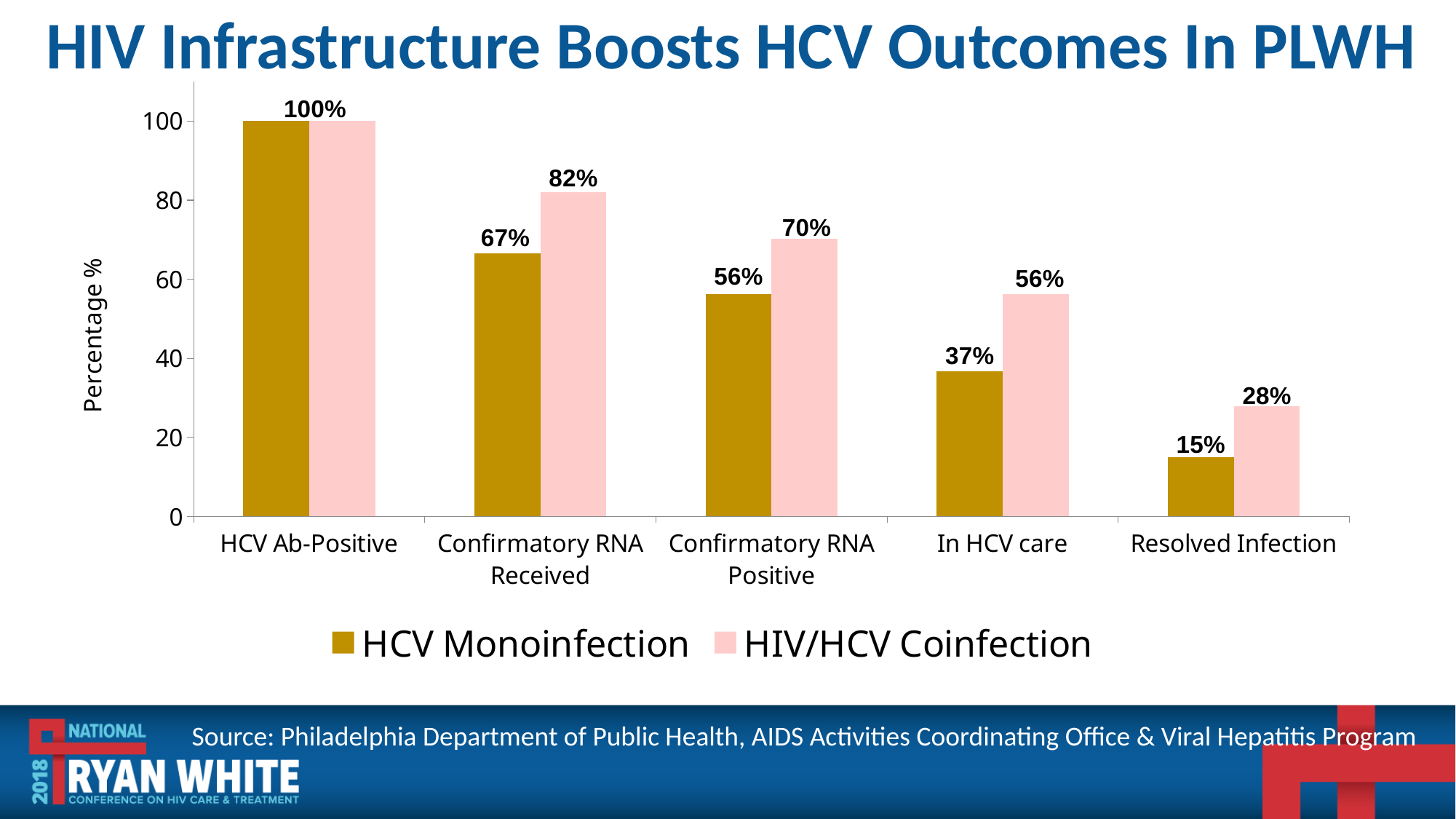
What is the HCV Monoinfection value for In HCV care? 37% What is the HIV/HCV Coinfection value for Confirmatory RNA Received? 82% Which category has the lowest HCV Monoinfection value? Resolved Infection How many categories are shown on the x axis? 5 How many series does the legend list? 2 What is the HCV Monoinfection value for Confirmatory RNA Positive? 56% What is the HIV/HCV Coinfection value for Resolved Infection? 28% What is the difference between the HIV/HCV Coinfection and HCV Monoinfection values for In HCV care? 19% What is the title of the chart? HIV Infrastructure Boosts HCV Outcomes In PLWH Do the HIV/HCV Coinfection values rise or fall from left to right across the categories? fall Which is larger for Confirmatory RNA Received: HCV Monoinfection or HIV/HCV Coinfection? HIV/HCV Coinfection What kind of chart is shown on the slide? bar chart